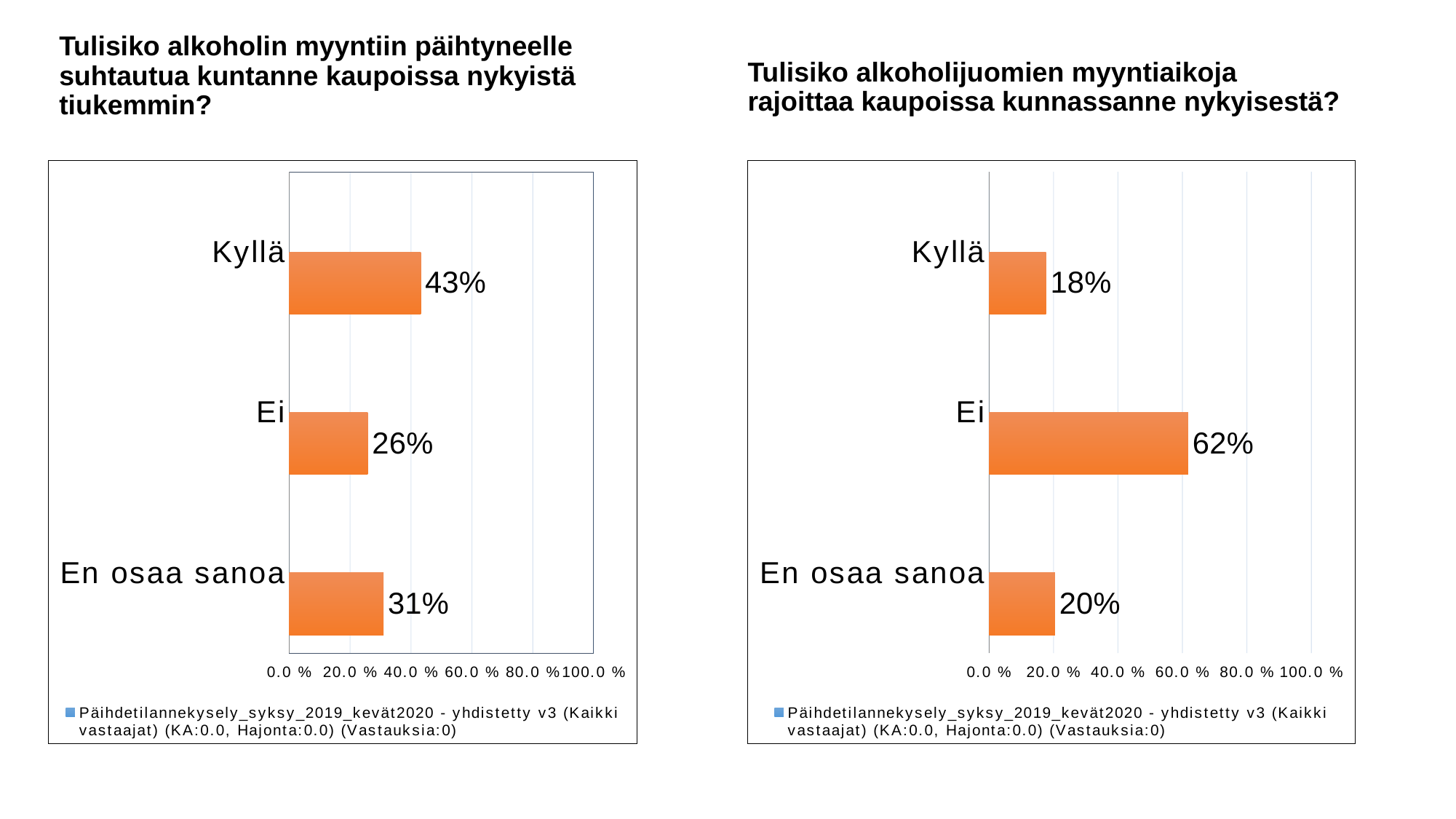
In the right chart, which is larger, the value for Kyllä or the value for En osaa sanoa? En osaa sanoa In the right chart (Tulisiko alkoholijuomien myyntiaikoja rajoittaa kaupoissa kunnassanne nykyisestä?), what is the value for Ei? 62% In the right chart, which category has the highest value? Ei How many categories does the left chart show? 3 In the right chart, what is the value for Kyllä? 18% In the left chart, which category has the highest value? Kyllä What kind of chart is the right chart? Bar chart In the left chart (Tulisiko alkoholin myyntiin päihtyneelle suhtautua kuntanne kaupoissa nykyistä tiukemmin?), what is the value for Kyllä? 43% In the left chart, what is the value for Ei? 26% In the left chart, which category has the lowest value? Ei In the right chart, what is the difference between the values for Ei and Kyllä? 44% In the left chart, what is the difference between the values for Kyllä and En osaa sanoa? 12%